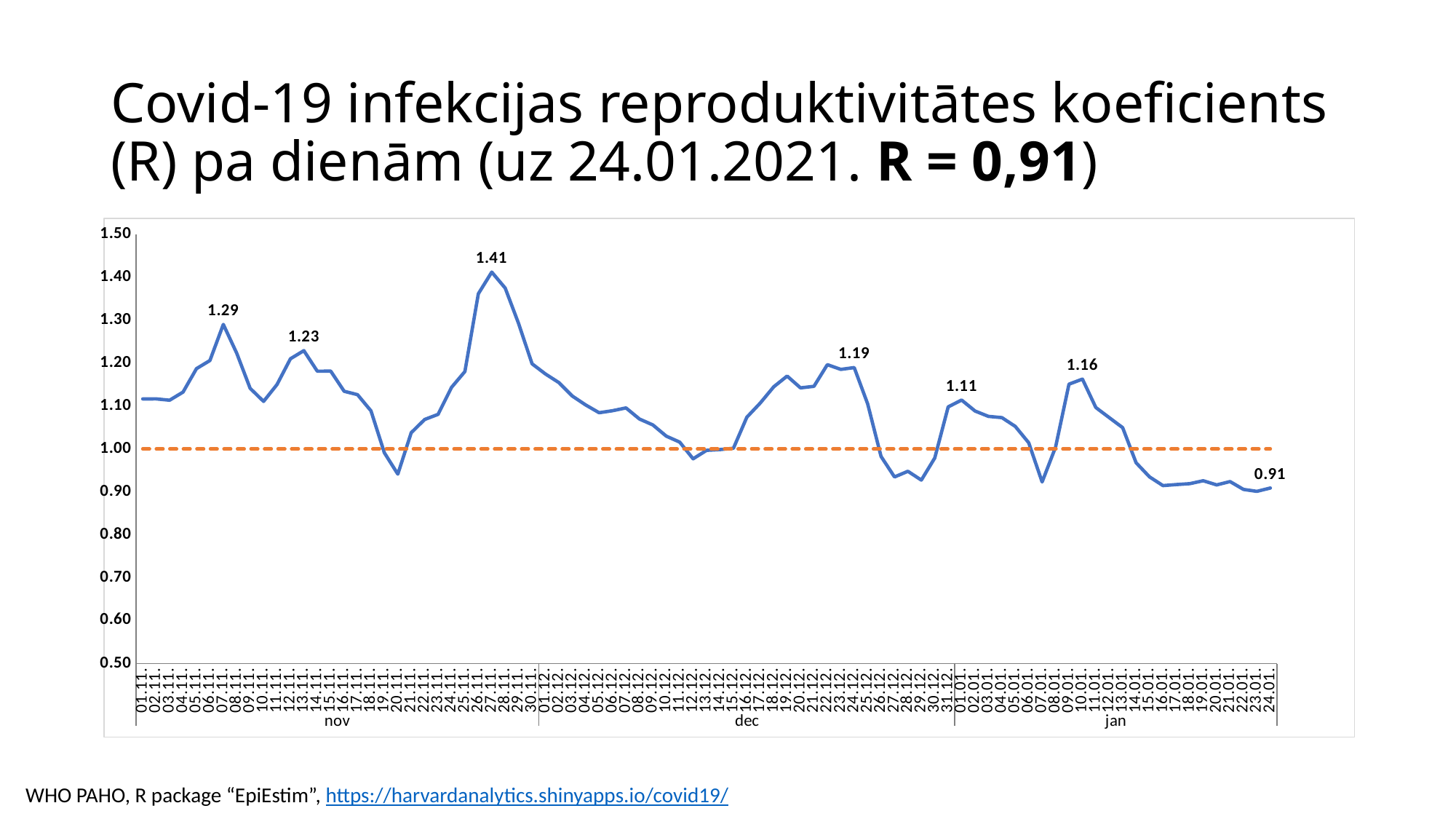
What is the R value labelled on 24.01.? 0.91 Is the R value on 07.01. greater or less than 1.00? less What kind of chart is shown on the slide? line chart What is the R value labelled on 10.01.? 1.16 Is the R value on 20.11. greater or less than 1.00? less What is the highest labelled R value on the chart? 1.41 At what level is the dashed orange horizontal line drawn? 1.00 Does the R value rise or fall from 10.01. to 24.01.? fall What is the difference between the labelled peak of 1.41 and the final value of 0.91? 0.50 Which labelled peak is higher, the one on 07.11. or the one on 13.11.? 07.11. What is the R value labelled on 07.11.? 1.29 What is the R value labelled on 27.11.? 1.41